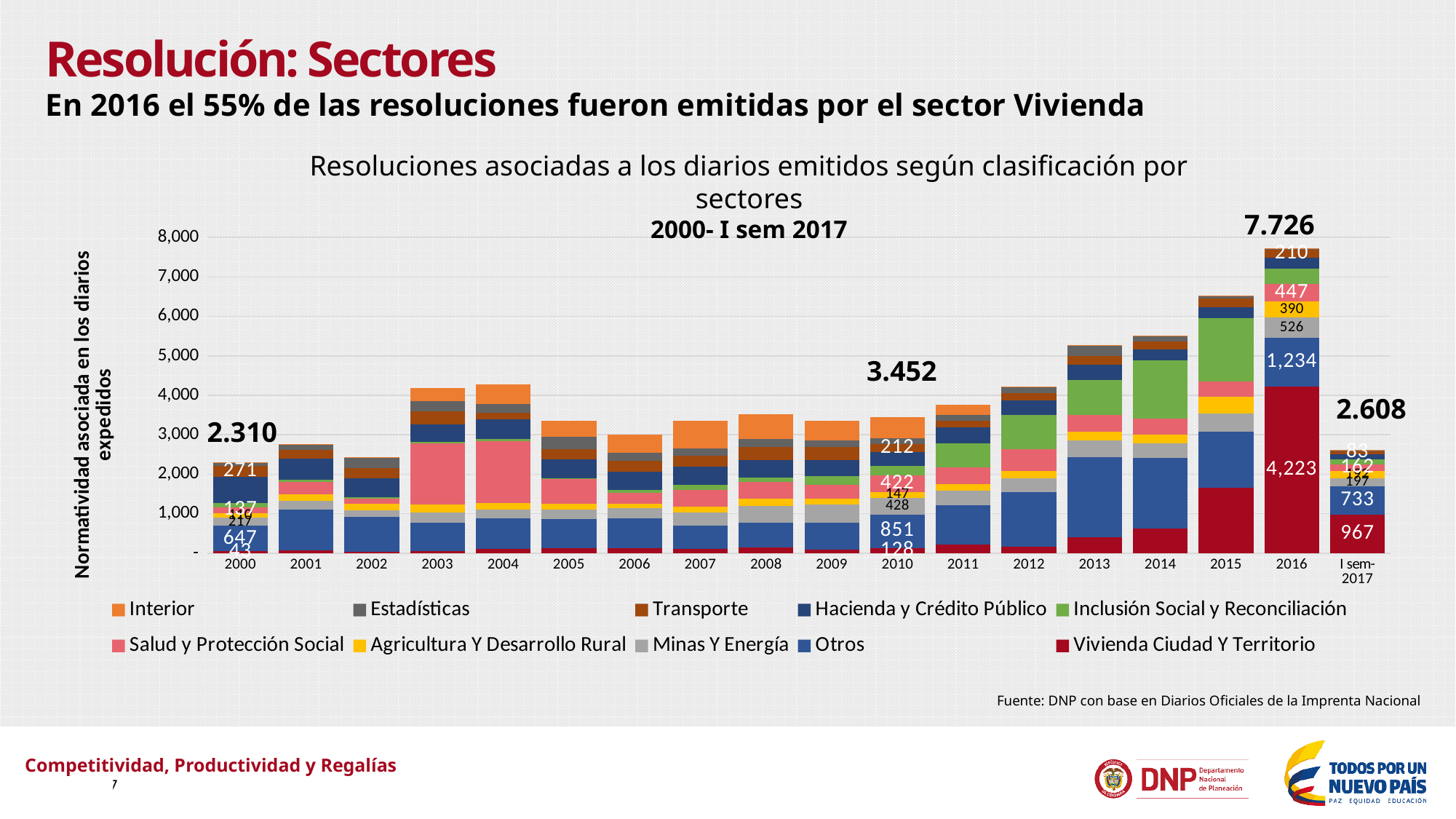
What is the value for Vivienda Ciudad Y Territorio in I sem-2017? 967 What is the difference between the Vivienda Ciudad Y Territorio value in 2016 and in I sem-2017? 3,256 What is the total labelled above the 2016 bar? 7.726 What kind of chart is shown on the slide? Stacked bar chart How many series does the legend list? 10 How many time periods (categories) are shown along the x axis? 18 Which year has the tallest total bar? 2016 Is the total for 2015 greater or less than 6,000? greater What is the value for Otros in 2010? 851 What is the value for Otros in 2016? 1,234 What is the total labelled above the 2010 bar? 3.452 What is the value for Vivienda Ciudad Y Territorio in 2016? 4,223